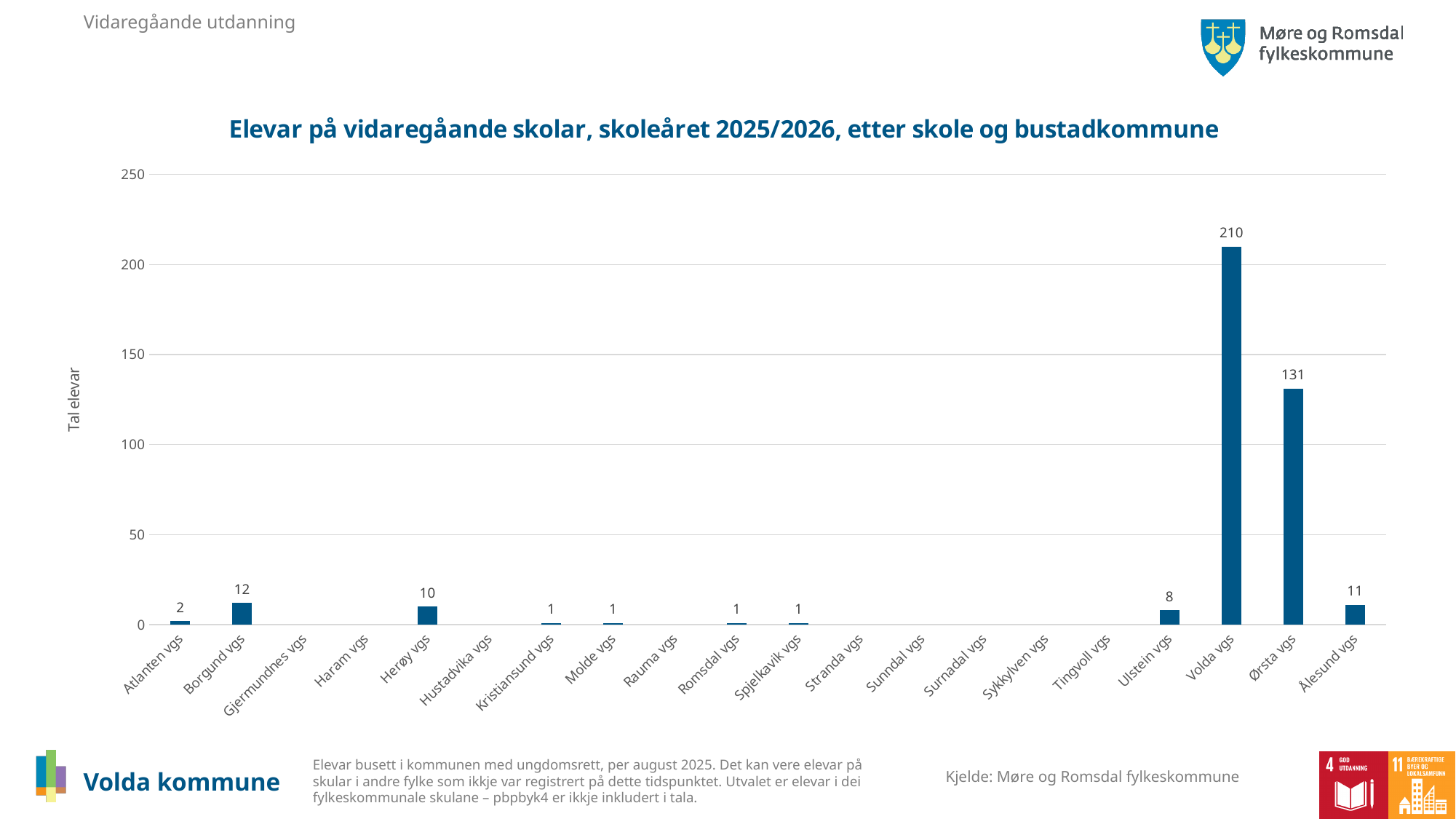
Which is larger, the value for Herøy vgs or the value for Ålesund vgs? Ålesund vgs What is the difference between the values for Volda vgs and Ørsta vgs? 79 Which school has the highest number of students? Volda vgs What kind of chart is shown on the slide? bar chart How many schools are listed on the x axis? 20 What is the difference between the values for Borgund vgs and Herøy vgs? 2 What is the value for Ørsta vgs? 131 What is the value for Borgund vgs? 12 Is the value for Ørsta vgs greater or less than 100? greater What is the value for Ulstein vgs? 8 What is the label of the y axis? Tal elevar How many students are shown for Volda vgs? 210